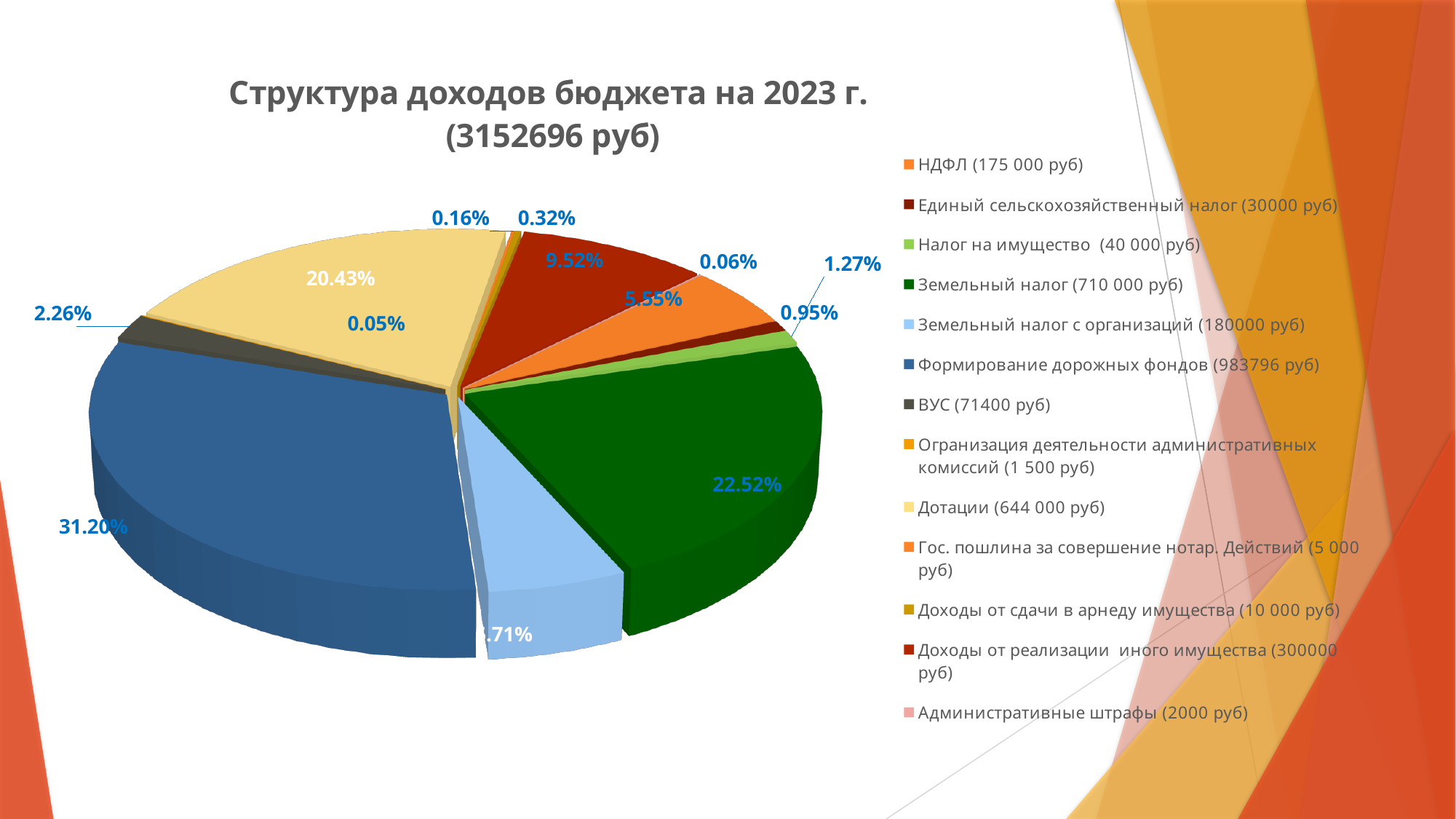
What is the title of the chart? Структура доходов бюджета на 2023 г. (3152696 руб) What share of the pie does Дотации take? 20.43% What share of the pie does Доходы от реализации иного имущества take? 9.52% Which category has the largest share of the pie? Формирование дорожных фондов How many categories does the legend list? 13 What share of the pie does Формирование дорожных фондов take? 31.20% What share of the pie does Земельный налог (710 000 руб) take? 22.52% What share of the pie does НДФЛ take? 5.55% What kind of chart is shown on the slide? pie chart What is the difference in percentage points between the shares of Формирование дорожных фондов and Земельный налог (710 000 руб)? 8.68% Which category has the smallest share of the pie? Огранизация деятельности административных комиссий Which has a larger share: Дотации or Доходы от реализации иного имущества? Дотации